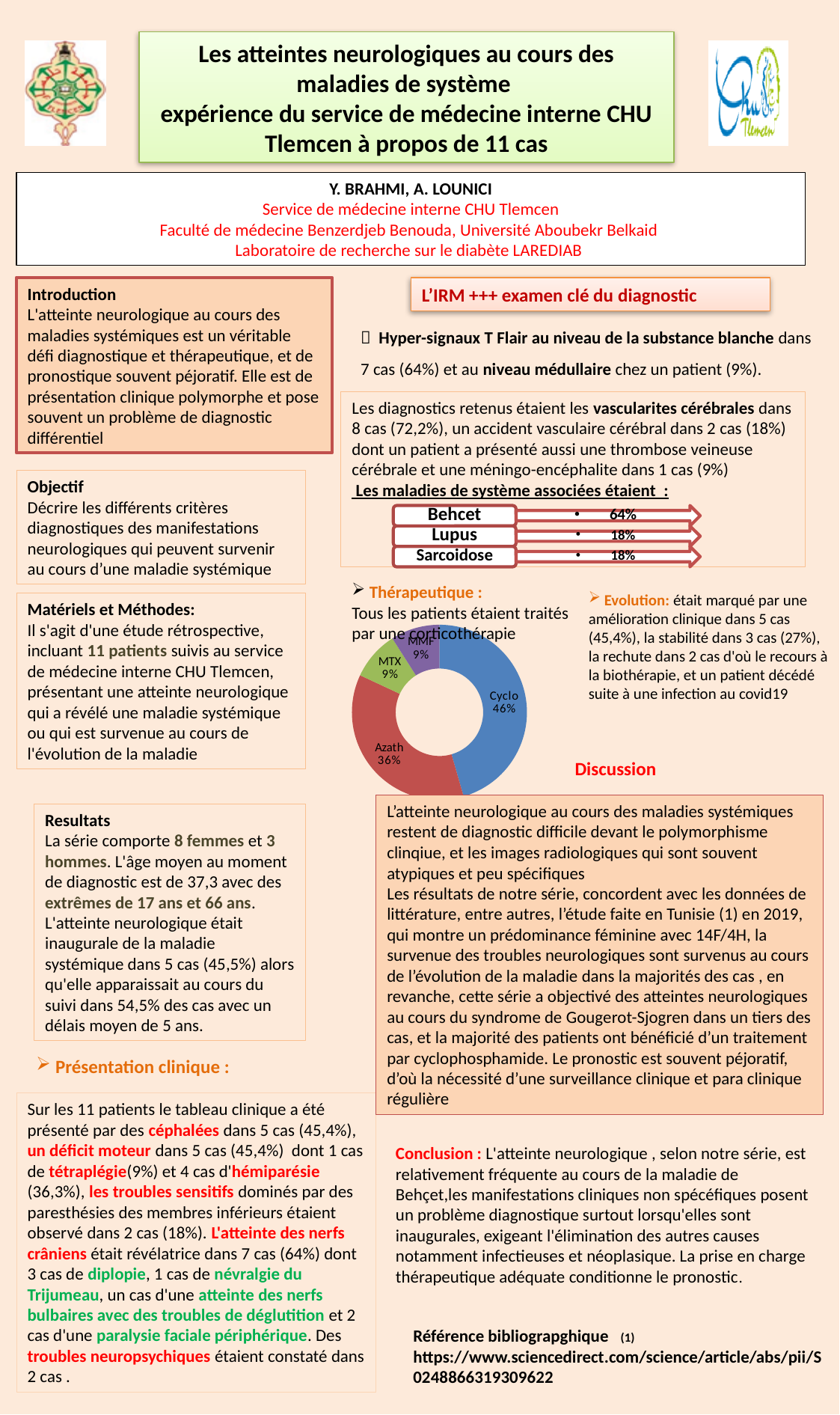
What colour is the Azath slice in the doughnut chart? red In the doughnut chart, which is larger, the Azath slice or the MTX slice? Azath Which treatment has the largest slice in the doughnut chart? Cyclo How many slices does the doughnut chart have? 4 What colour is the Cyclo slice in the doughnut chart? blue In the doughnut chart, what share is labelled for MTX? 9% In the doughnut chart, what is the difference between the Cyclo and Azath shares? 10% In the doughnut chart, what share is labelled for Cyclo? 46% In the doughnut chart, what share is labelled for Azath? 36% In the doughnut chart, what share is labelled for MMF? 9% What kind of chart is shown in the Thérapeutique section? doughnut chart In the doughnut chart, what is the combined share of MTX and MMF? 18%